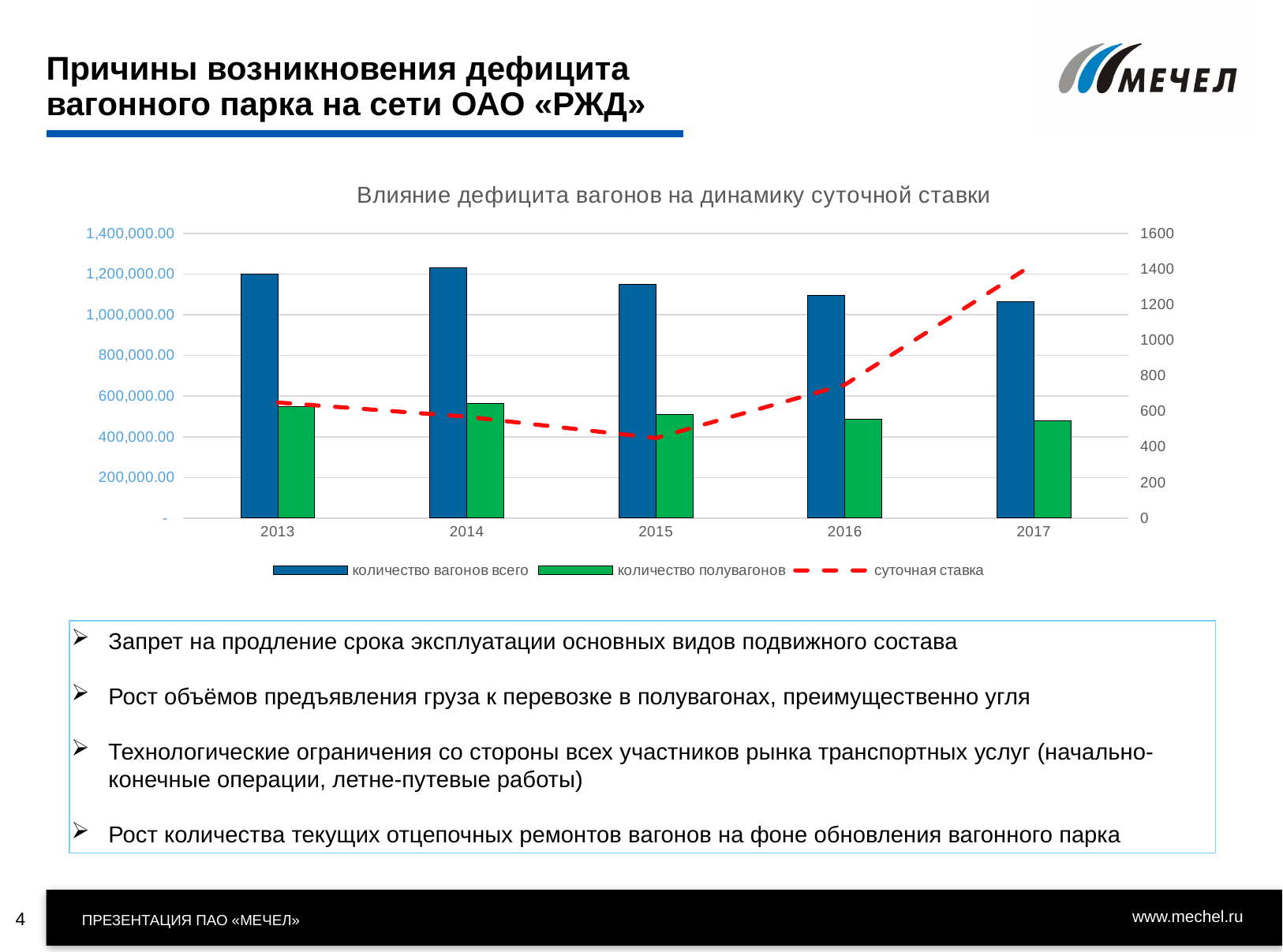
How many series does the chart legend list? 3 Is the value of 'суточная ставка' in 2017 greater or less than 1200 on the right axis? greater How many years are shown on the x axis of the chart? 5 Is the value for 'количество вагонов всего' in 2013 greater or less than 1,000,000.00? greater In which year is the 'суточная ставка' line at its highest? 2017 In which year is the 'суточная ставка' line at its lowest? 2015 Does the 'суточная ставка' line rise or fall from 2015 to 2017? rise In which year is the value for 'количество вагонов всего' lowest? 2017 Is the value for 'количество полувагонов' in 2017 greater or less than 600,000.00? less In which year is the value for 'количество вагонов всего' highest? 2014 Which year has the larger value for 'количество вагонов всего', 2014 or 2016? 2014 What kind of chart is shown on the slide? bar chart with a line